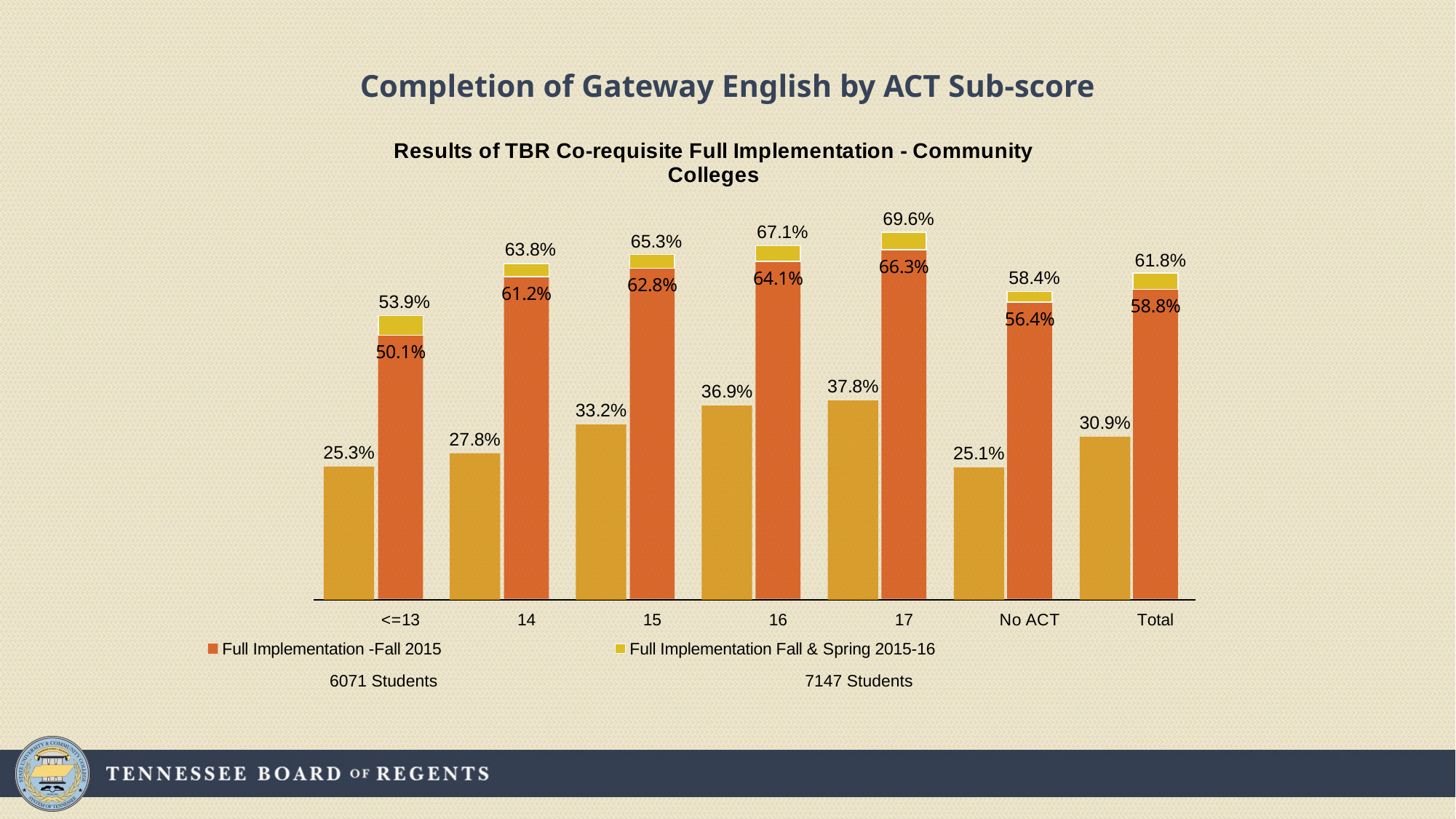
How many series does the legend list? 2 What is the Full Implementation Fall & Spring 2015-16 value for the No ACT category? 58.4% For the Total category, what is the difference between the Full Implementation Fall & Spring 2015-16 value and the Full Implementation -Fall 2015 value? 3.0 percentage points Which category has the highest Full Implementation Fall & Spring 2015-16 value? 17 Which category has the lowest Full Implementation -Fall 2015 value? <=13 What is the Full Implementation -Fall 2015 value for the Total category? 58.8% For ACT sub-score 17, how much higher is the Full Implementation Fall & Spring 2015-16 value than the Full Implementation -Fall 2015 value? 3.3 percentage points How many categories are shown on the x axis? 7 What kind of chart is shown on the slide? Bar chart What is the Full Implementation -Fall 2015 value for ACT sub-score 16? 64.1% How many students are noted under the Full Implementation Fall & Spring 2015-16 legend entry? 7147 Students Which has the larger Full Implementation -Fall 2015 value, ACT sub-score 14 or 15? 15